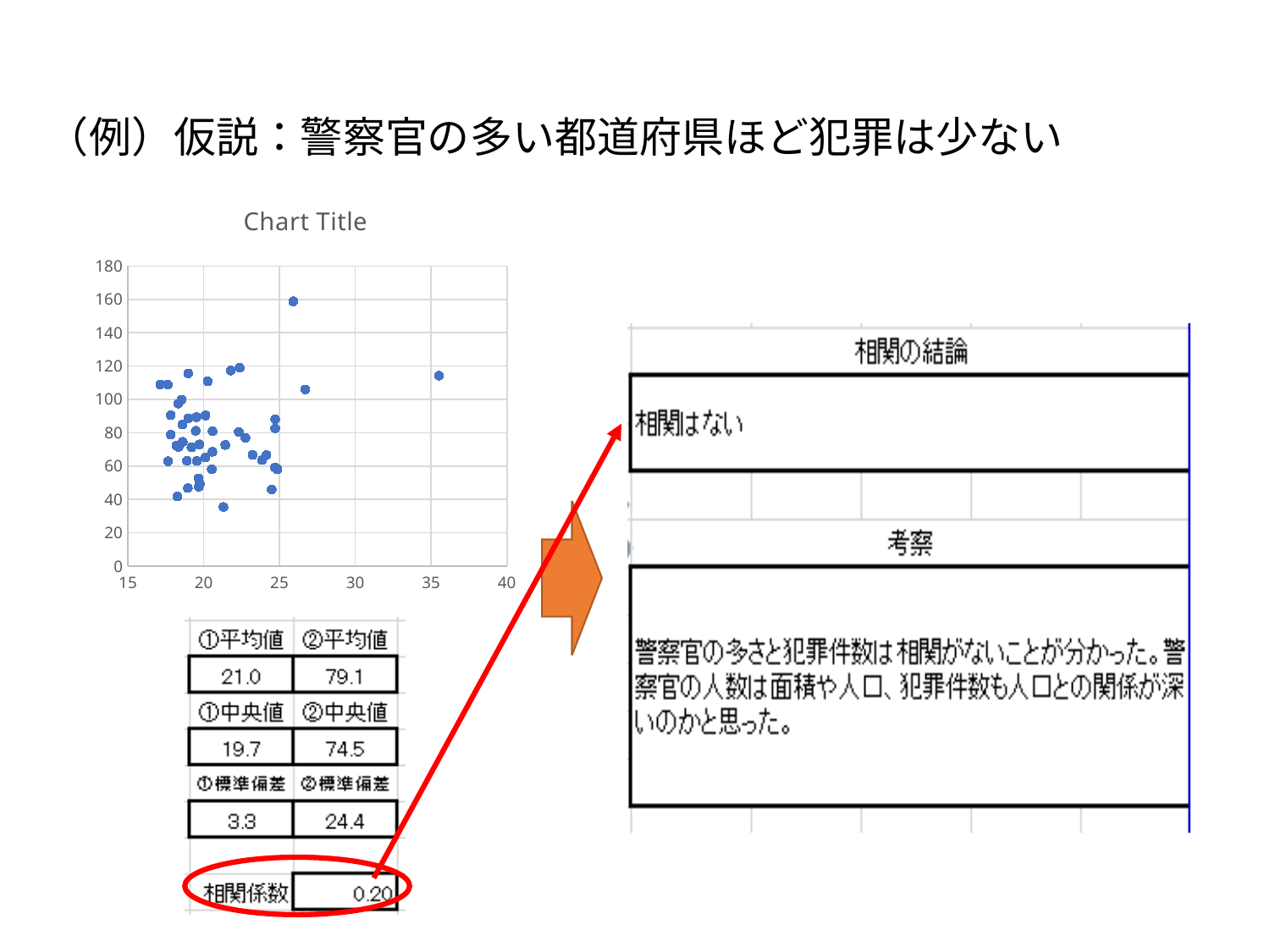
Is the y value of the rightmost point on the chart greater or less than 100? greater Is the x value of the rightmost point on the chart greater or less than 30? greater What kind of chart is shown on the slide? scatter chart Do the points on the chart show a clear rising or falling trend along the x axis? no clear trend Is the y value of the highest point on the chart greater or less than 140? greater What is the title of the chart? Chart Title What is the highest value shown on the chart's vertical axis? 180